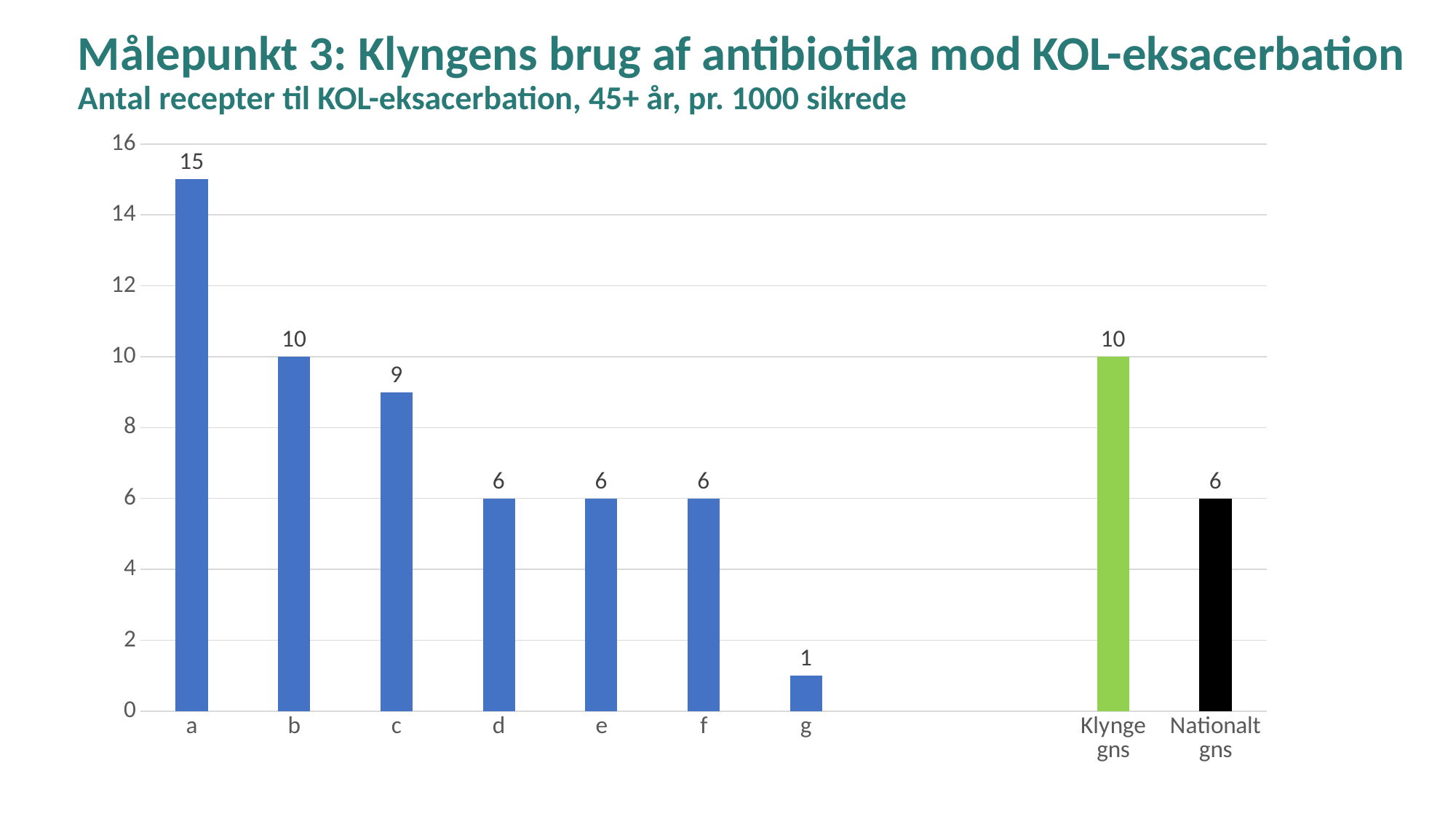
What is the value for category c? 9 What kind of chart is shown on the slide? bar chart What is the value for category a? 15 What is the value for Klynge gns? 10 Which category has the lowest value? g What is the difference between Klynge gns and Nationalt gns? 4 Is the value for a greater or less than 14? greater Which category has the highest value? a How many bars are plotted in the chart? 9 What is the value for Nationalt gns? 6 Which is larger, the value for b or the value for c? b What is the difference between the values for a and b? 5